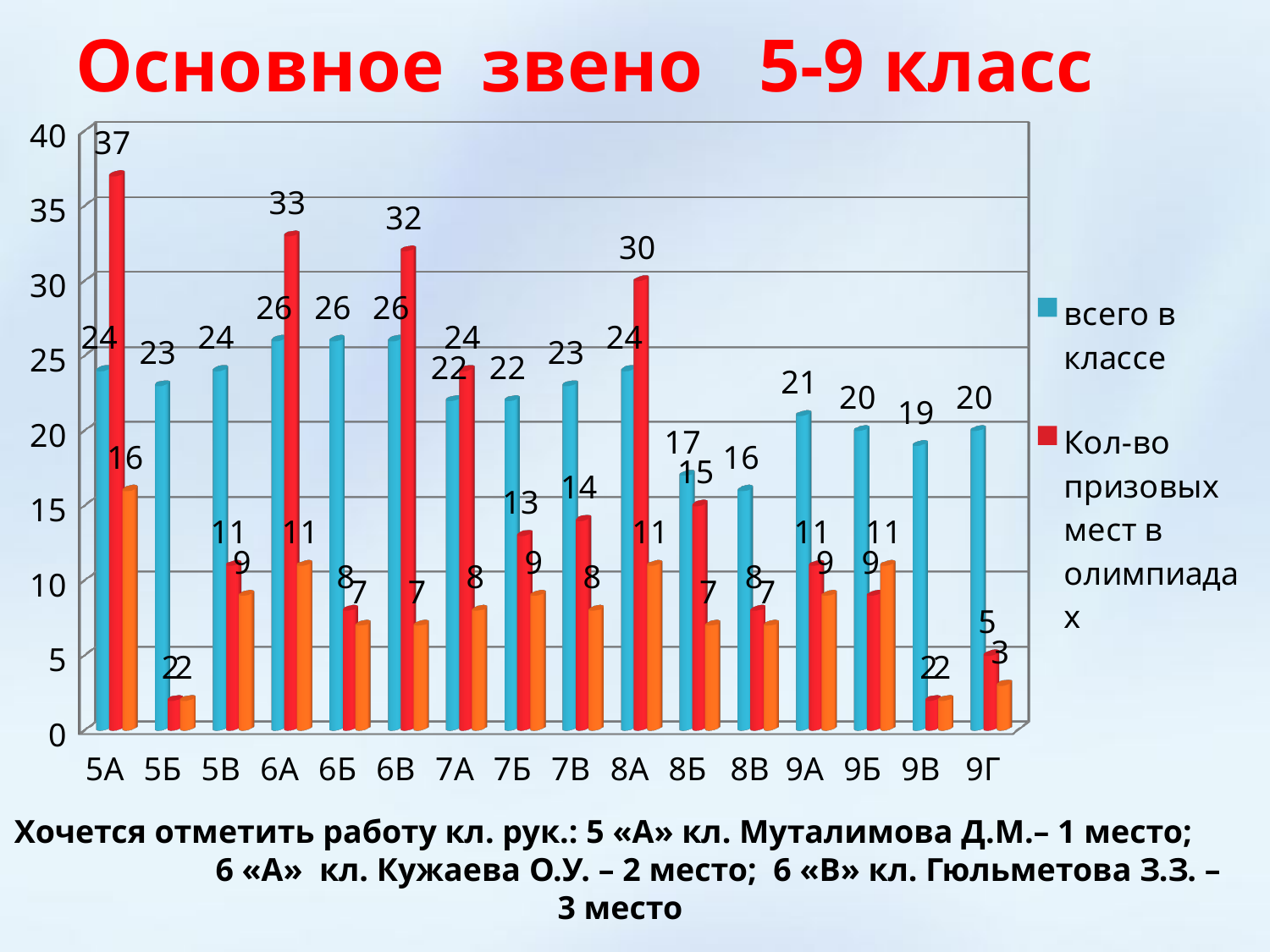
How many series does the legend list? 2 What is the title of the slide containing the chart? Основное звено 5-9 класс Is the value of 'Кол-во призовых мест в олимпиадах' for class 9Г greater or less than 10? less Which class has the highest value for 'Кол-во призовых мест в олимпиадах'? 5А What is the difference between 'Кол-во призовых мест в олимпиадах' for 5А and for 6В? 5 What is the value of 'Кол-во призовых мест в олимпиадах' for class 8А? 30 How many classes (categories) are shown on the x axis? 16 What is the value of 'Кол-во призовых мест в олимпиадах' for class 6А? 33 Which class has the lowest value for 'всего в классе'? 8В Which is larger for class 7А: 'всего в классе' or 'Кол-во призовых мест в олимпиадах'? Кол-во призовых мест в олимпиадах What is the value of 'всего в классе' for class 5А? 24 What type of chart is shown on the slide? bar chart